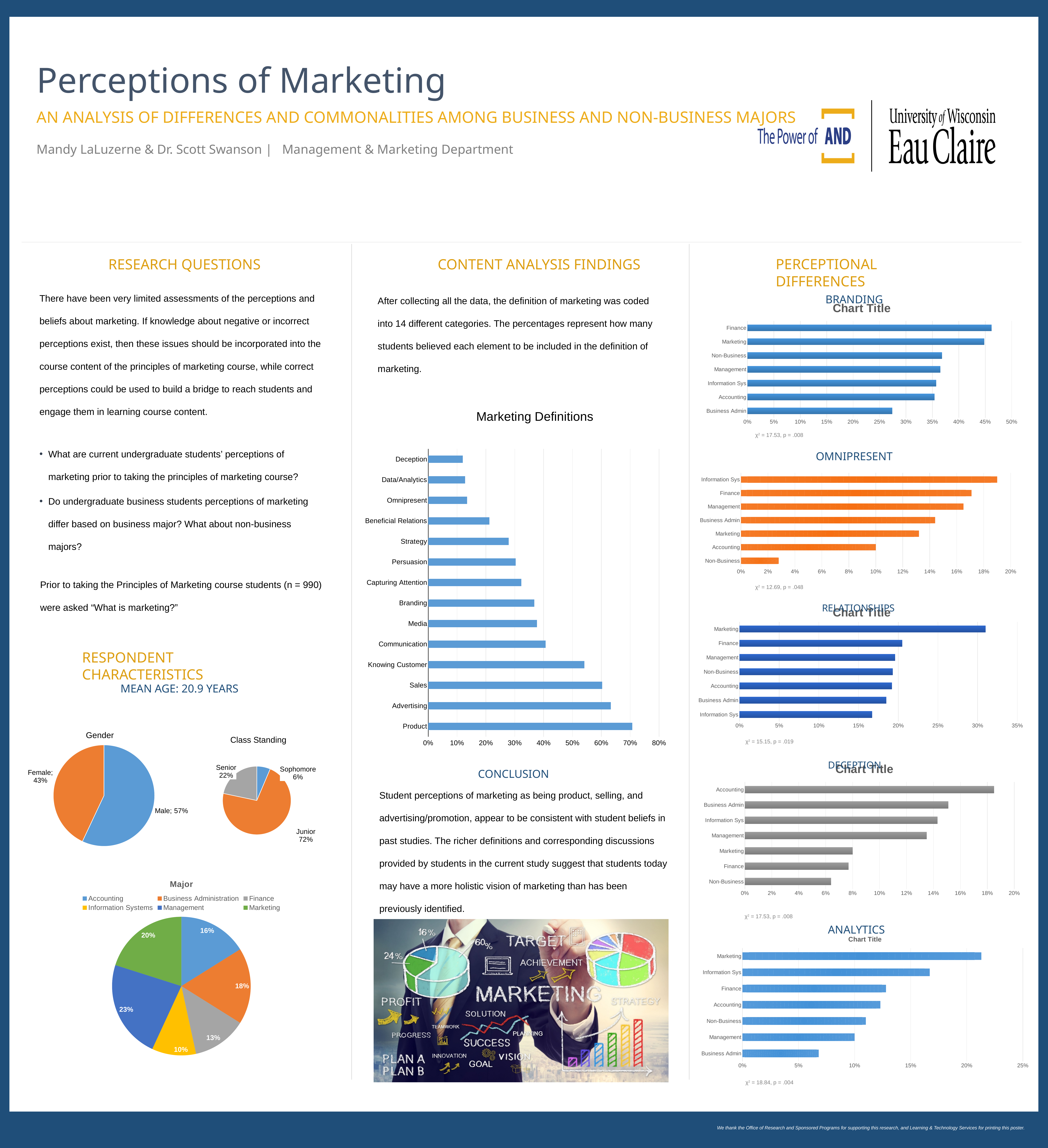
What kind of chart is the Marketing Definitions chart? bar chart In the Marketing Definitions chart, how many categories are plotted? 14 In the Gender pie chart, what percentage of respondents are Male? 57% In the Branding chart, which major has the lowest value? Business Admin In the Class Standing pie chart, what share of respondents are Juniors? 72% In the Omnipresent chart, is the value for Non-Business greater or less than 4%? less How many majors does the legend of the Major pie chart list? 6 In the Analytics chart, which is larger, the value for Marketing or the value for Business Admin? Marketing In the Major pie chart, what is the difference between the Management share and the Information Systems share? 13% In the Marketing Definitions chart, which category has the highest value? Product In the Marketing Definitions chart, is the value for Sales greater or less than 50%? greater In the Class Standing pie chart, which class standing has the smallest slice? Sophomore